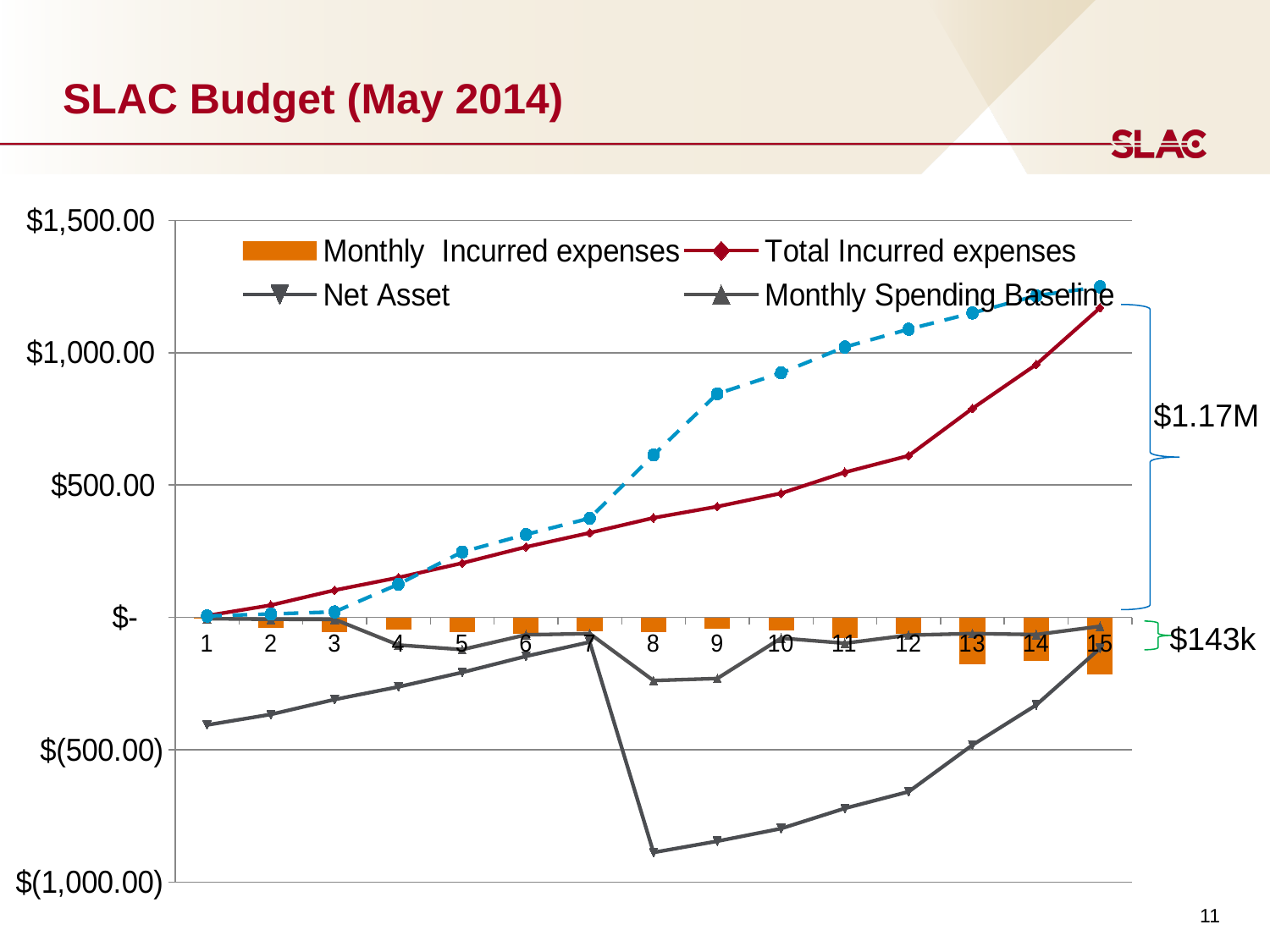
Does the Total Incurred expenses series rise or fall from point 1 to point 15? Rise Is the value of Total Incurred expenses at point 15 greater or less than $1,000.00? greater Is the value of Net Asset at point 8 greater or less than $(500.00)? less Is the value of Total Incurred expenses at point 12 greater or less than $500.00? greater How many points are on the x axis? 15 What value is annotated by the large bracket on the right side of the chart? $1.17M What kind of chart is shown? Combined bar and line chart Which is larger, the Net Asset value at point 1 or at point 8? Point 1 At which x-axis point is Total Incurred expenses highest? 15 At which x-axis point is Net Asset lowest? 8 How many series does the legend list? 4